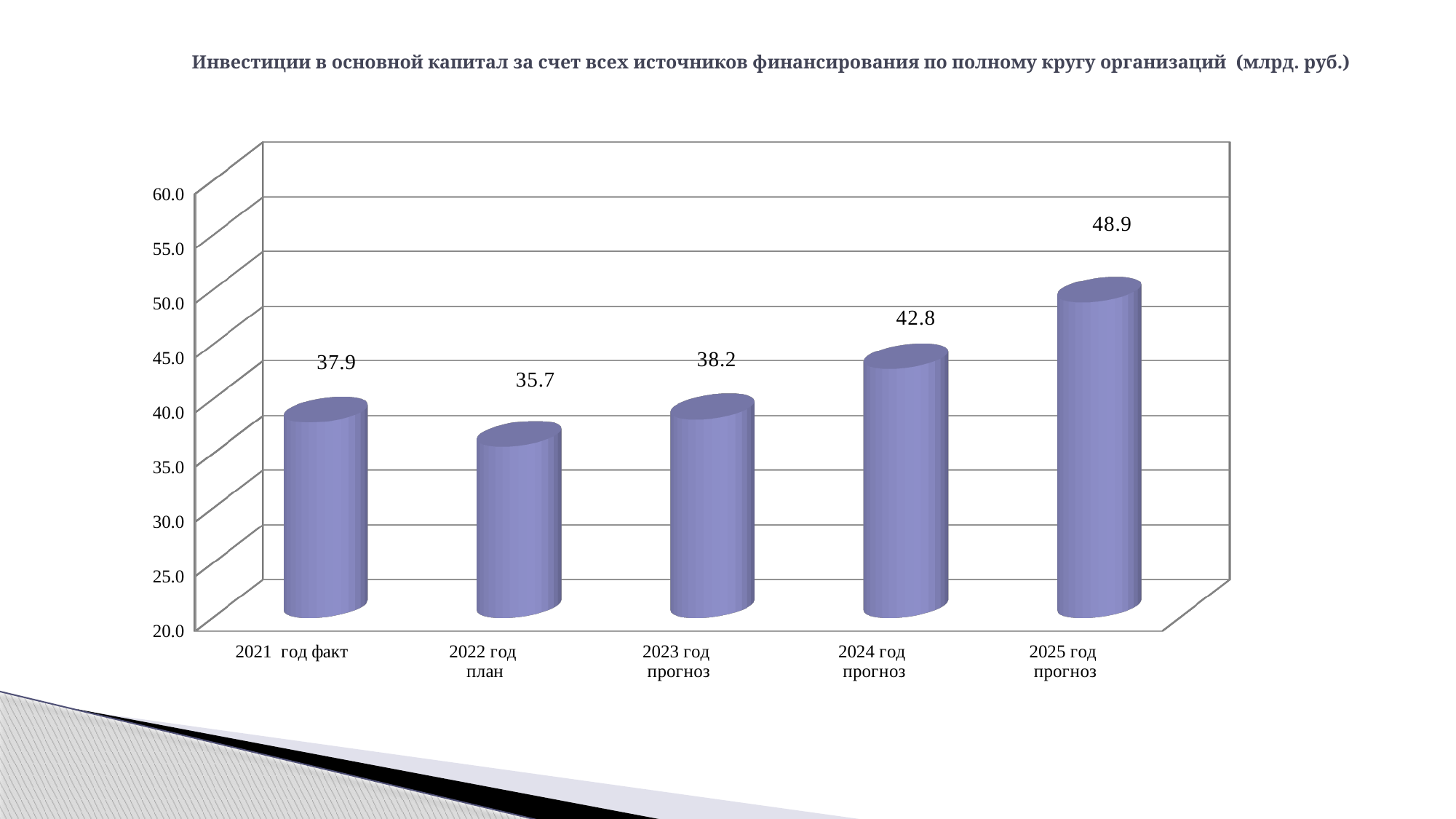
Do the values rise or fall from 2022 год план to 2025 год прогноз? rise Is the value for 2025 год прогноз greater or less than 45.0? greater Which category has the lowest value? 2022 год план What is the difference between the values for 2021 год факт and 2022 год план? 2.2 Which is larger, the value for 2023 год прогноз or the value for 2021 год факт? 2023 год прогноз How many categories are shown on the x axis? 5 What is the value for 2022 год план? 35.7 What kind of chart is shown on the slide? bar chart Which category has the highest value? 2025 год прогноз What is the value for 2024 год прогноз? 42.8 What is the value for 2021 год факт? 37.9 What is the difference between the values for 2025 год прогноз and 2024 год прогноз? 6.1